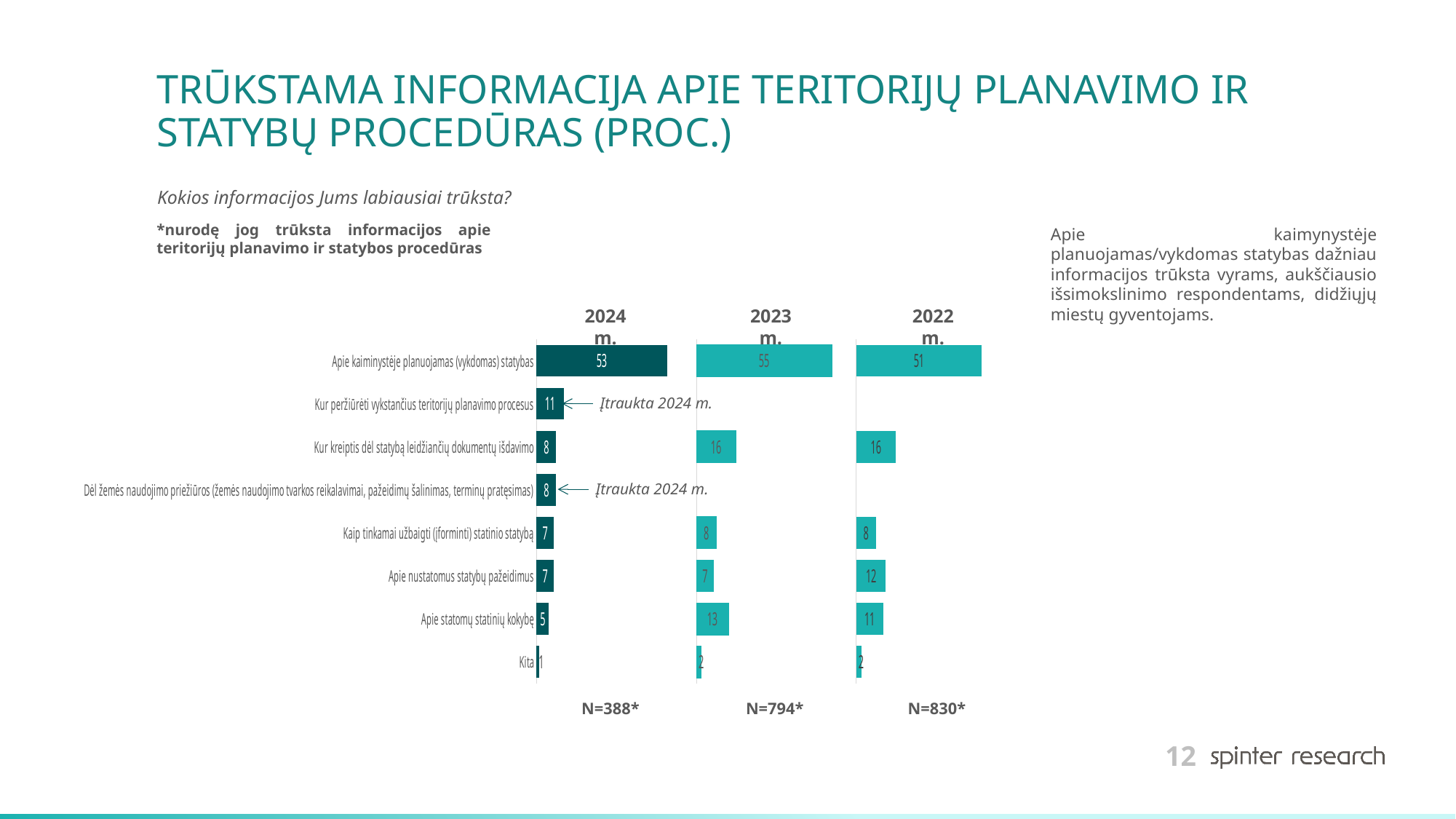
Which is larger: the 2023 m. value or the 2022 m. value for "Apie statomų statinių kokybę"? 2023 m. In the 2022 m. chart, what is the value for "Apie nustatomus statybų pažeidimus"? 12 Which two categories are marked as "Įtraukta 2024 m."? Kur peržiūrėti vykstančius teritorijų planavimo procesus; Dėl žemės naudojimo priežiūros In the 2022 m. chart, which category has the highest value? Apie kaiminystėje planuojamas (vykdomas) statybas What type of chart is used on this slide? Bar chart In the 2023 m. chart, which category has the lowest value? Kita In the 2024 m. chart, what is the value for "Apie kaiminystėje planuojamas (vykdomas) statybas"? 53 How many categories are shown in the 2024 m. chart? 8 What is the difference between the 2023 m. and 2022 m. values for "Apie kaiminystėje planuojamas (vykdomas) statybas"? 4 What is the sample size (N) shown under the 2024 m. chart? N=388* In the 2024 m. chart, what is the value for "Kur peržiūrėti vykstančius teritorijų planavimo procesus"? 11 In the 2023 m. chart, what is the value for "Kur kreiptis dėl statybą leidžiančių dokumentų išdavimo"? 16